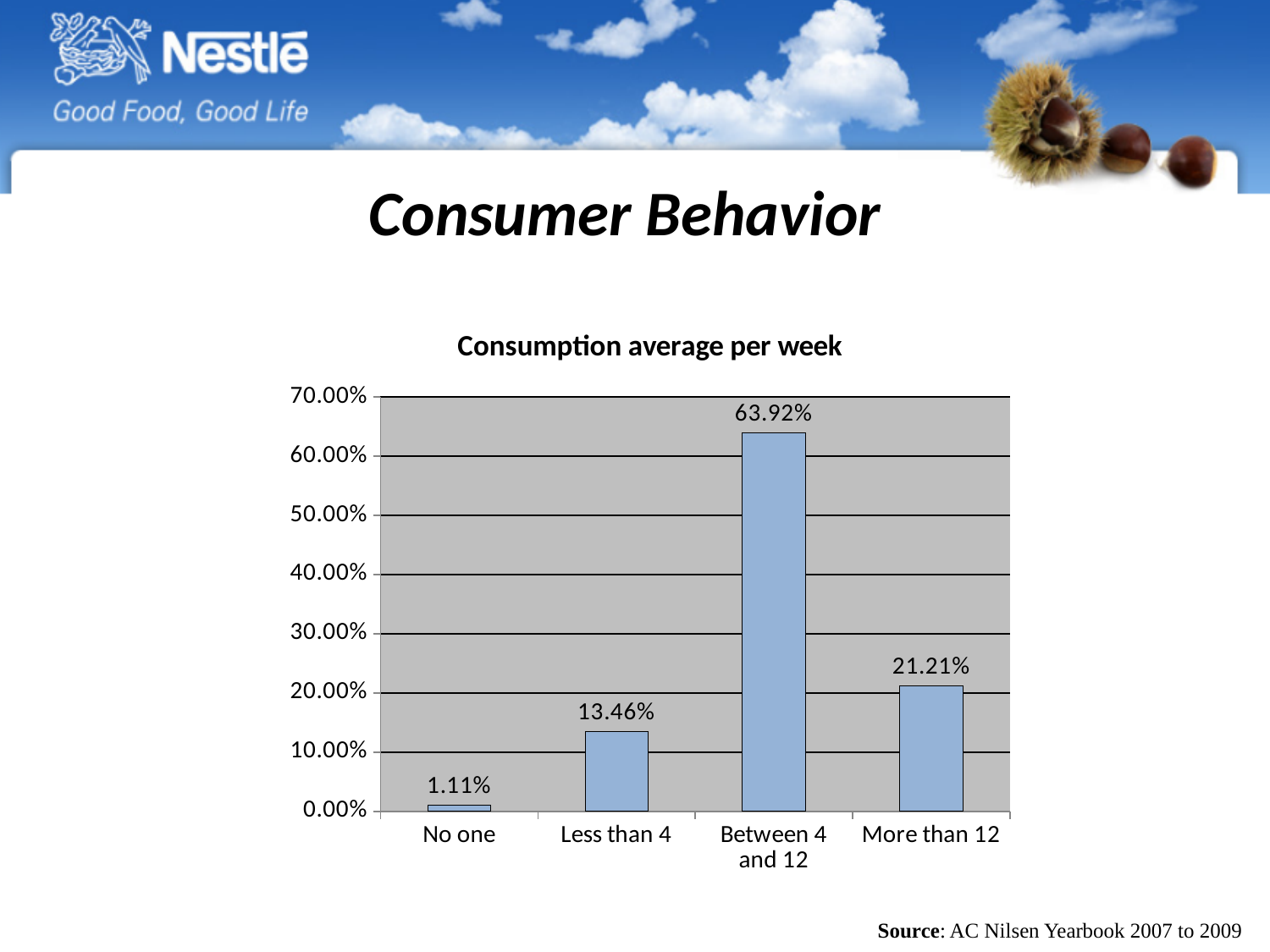
What is the value for "No one" in the Consumption average per week chart? 1.11% How many categories are shown in the Consumption average per week chart? 4 What is the value for "Less than 4" in the Consumption average per week chart? 13.46% Which is larger, the value for "More than 12" or the value for "Less than 4"? More than 12 Which category has the lowest value in the Consumption average per week chart? No one What kind of chart is shown on the slide? Bar chart What is the difference between the values for "Less than 4" and "No one"? 12.35% Which category has the highest value in the Consumption average per week chart? Between 4 and 12 Is the value for "Between 4 and 12" greater or less than 60.00%? greater What is the difference between the values for "Between 4 and 12" and "More than 12"? 42.71% What is the value for "Between 4 and 12" in the Consumption average per week chart? 63.92% What is the value for "More than 12" in the Consumption average per week chart? 21.21%